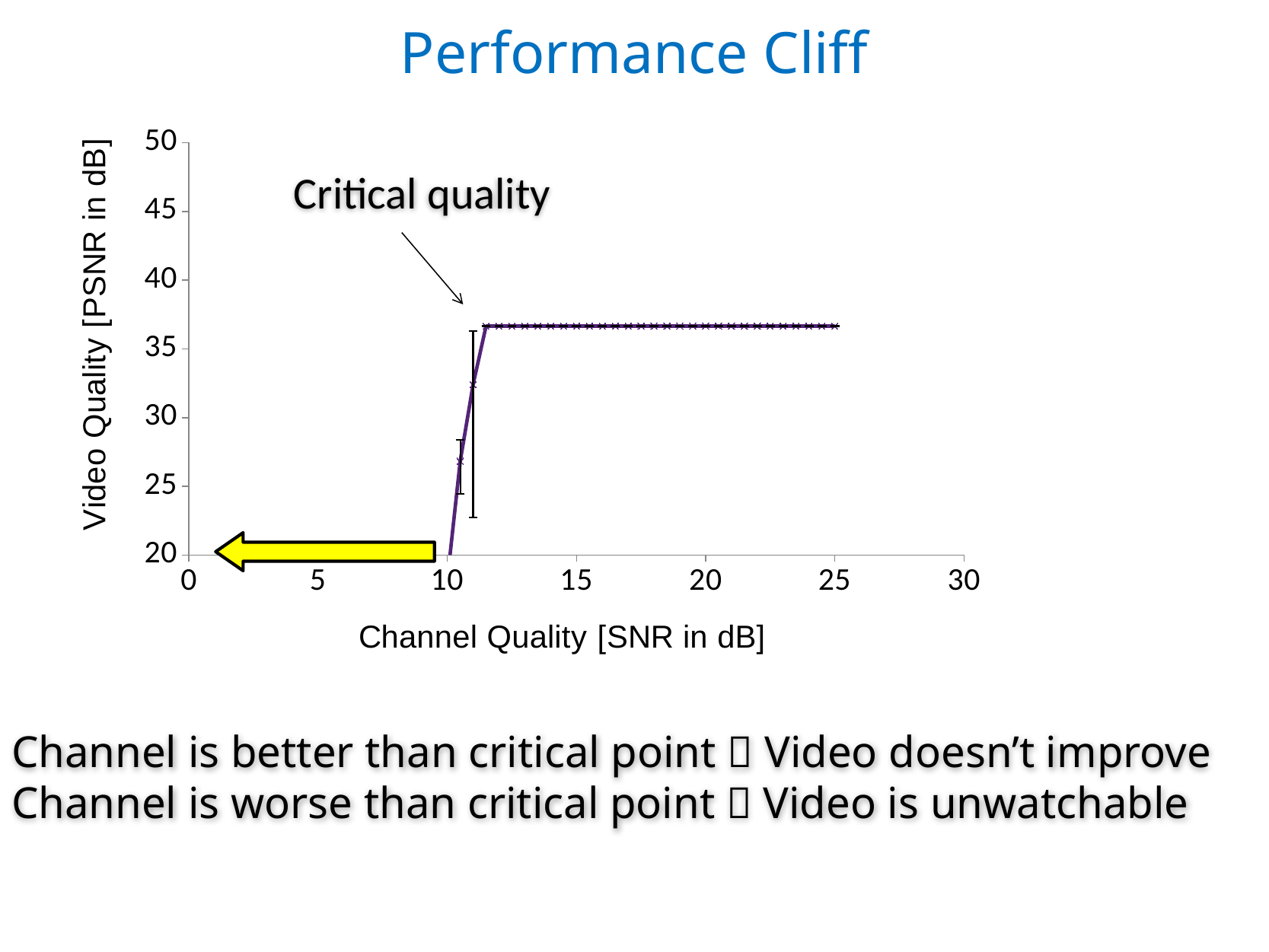
Is the video quality at a channel quality of 25 dB greater or less than 30? greater Is the video quality at a channel quality of 20 dB greater or less than 35? greater Which has the lower video quality: channel quality 11 dB or channel quality 15 dB? 11 dB Between channel quality 15 dB and 25 dB, does video quality rise, fall, or stay flat? stay flat What is the label of the x axis? Channel Quality [SNR in dB] Which has the higher video quality: channel quality 10.5 dB or channel quality 20 dB? 20 dB As channel quality increases from 10 dB to 12 dB, does video quality rise or fall? rise What kind of chart is shown on the slide? line chart Is the video quality at a channel quality of about 10.5 dB greater or less than 30? less What is the title of the chart on the slide? Performance Cliff